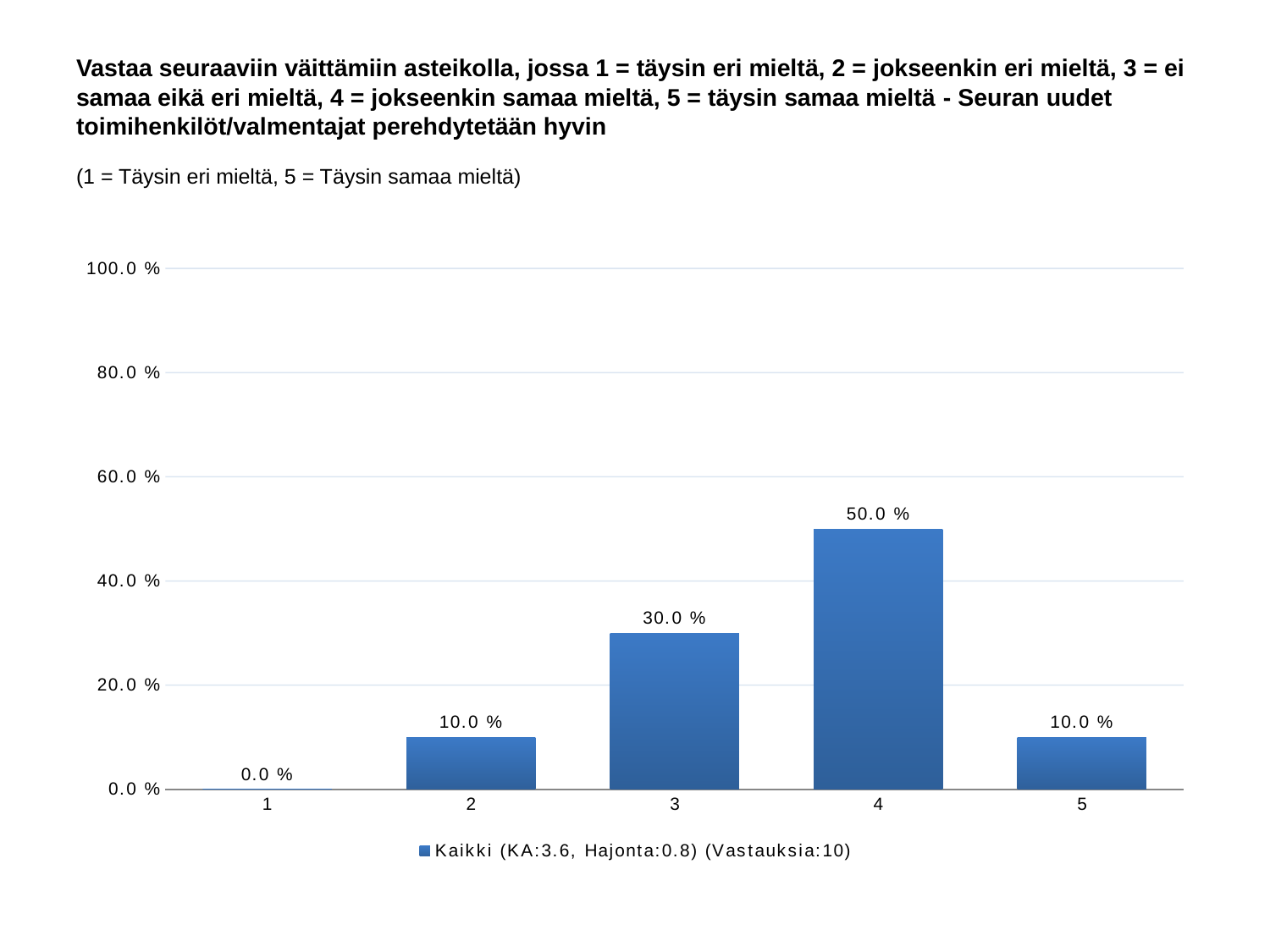
What is the value for category 1? 0.0 % How many categories are shown on the x axis? 5 What is the legend entry for the series? Kaikki (KA:3.6, Hajonta:0.8) (Vastauksia:10) How many series does the legend list? 1 What is the value for category 4? 50.0 % Is the value for category 4 greater or less than 40.0 %? greater What kind of chart is shown? bar chart What is the value for category 3? 30.0 % Which category has the lowest value? 1 What is the difference between the values for category 4 and category 3? 20.0 % Which category has the highest value? 4 Which is larger, the value for category 3 or the value for category 5? 3